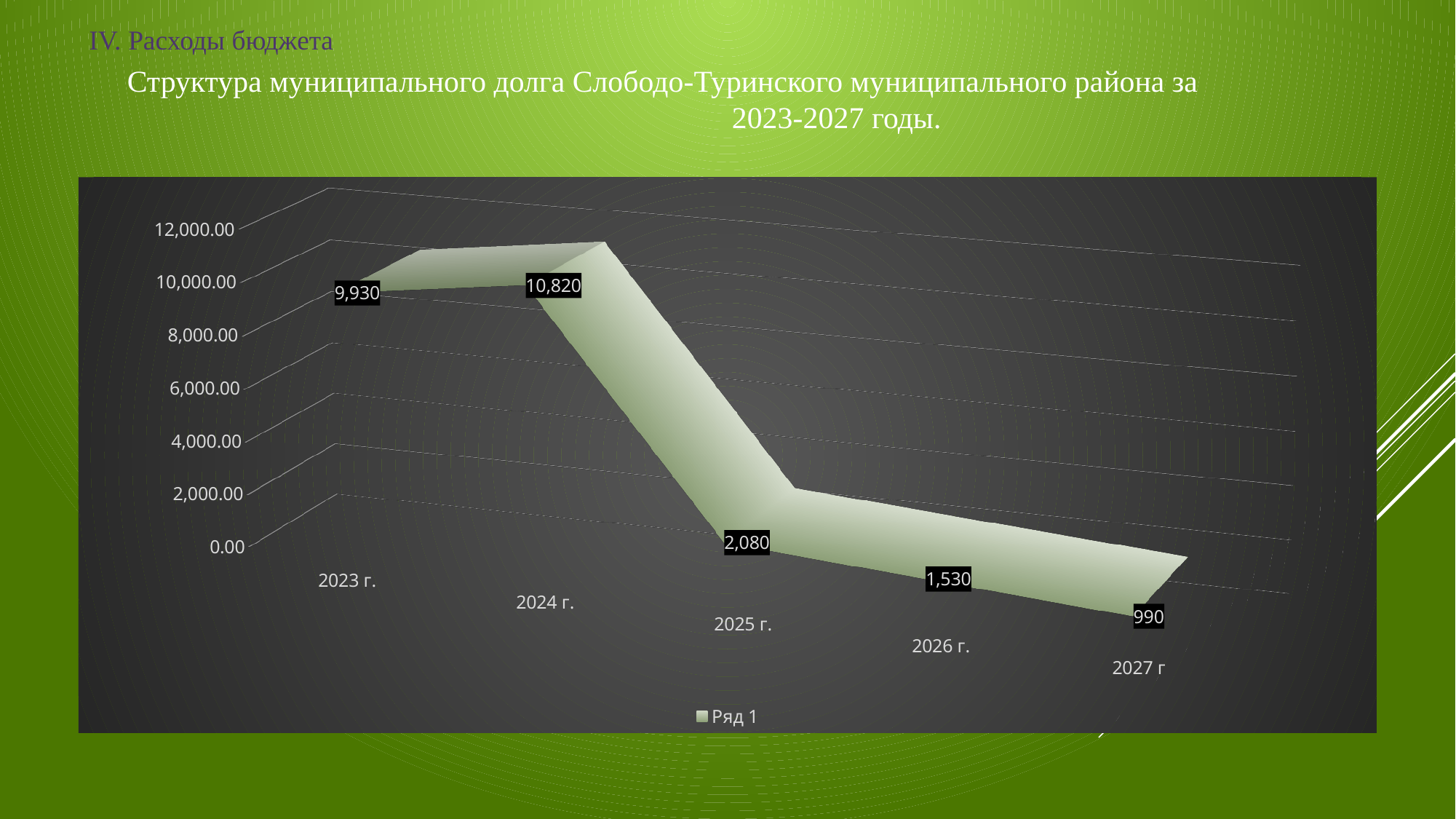
Which year has the highest value? 2024 г. Which is larger, the value for 2023 г. or the value for 2026 г.? 2023 г. How many years are shown on the x axis? 5 How many series does the legend list? 1 What is the value for 2024 г.? 10,820 What is the difference between the values for 2024 г. and 2025 г.? 8,740 What is the value for 2025 г.? 2,080 What is the value for 2023 г.? 9,930 What is the name of the series in the legend? Ряд 1 Which year has the lowest value? 2027 г What is the value for 2027 г? 990 Is the value for 2026 г. greater or less than 2,000.00? less